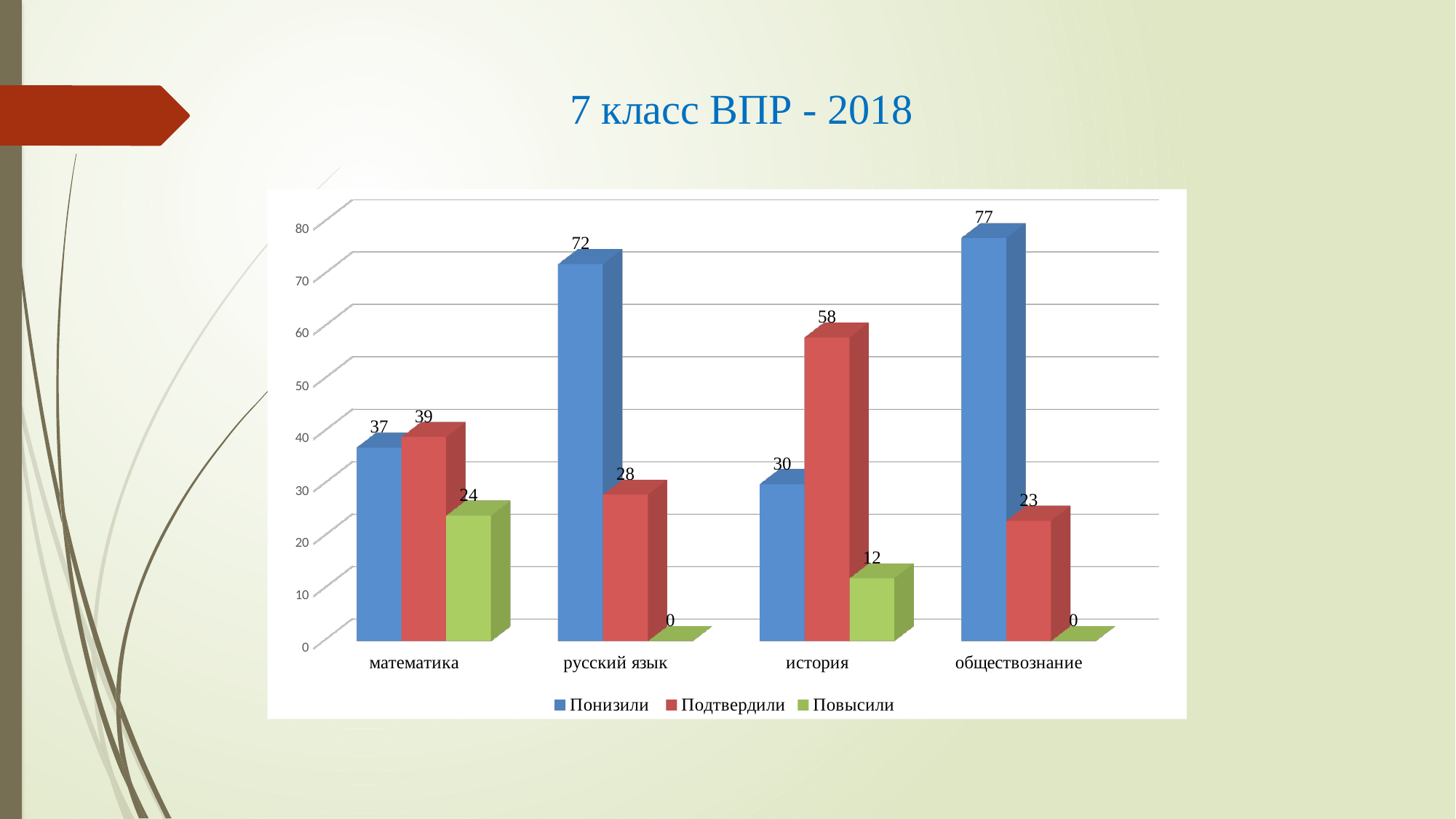
Which is larger in математика: Понизили or Подтвердили? Подтвердили Which category has the highest value for Понизили? обществознание What is the value for Подтвердили in история? 58 What is the total of the three series for история? 100 What is the value for Повысили in математика? 24 What is the title of the slide? 7 класс ВПР - 2018 Which category has the lowest value for Подтвердили? обществознание What is the value for Понизили in русский язык? 72 What kind of chart is shown on the slide? bar chart How many series does the legend list? 3 What is the difference between Понизили and Подтвердили in обществознание? 54 How many categories are shown on the x axis? 4